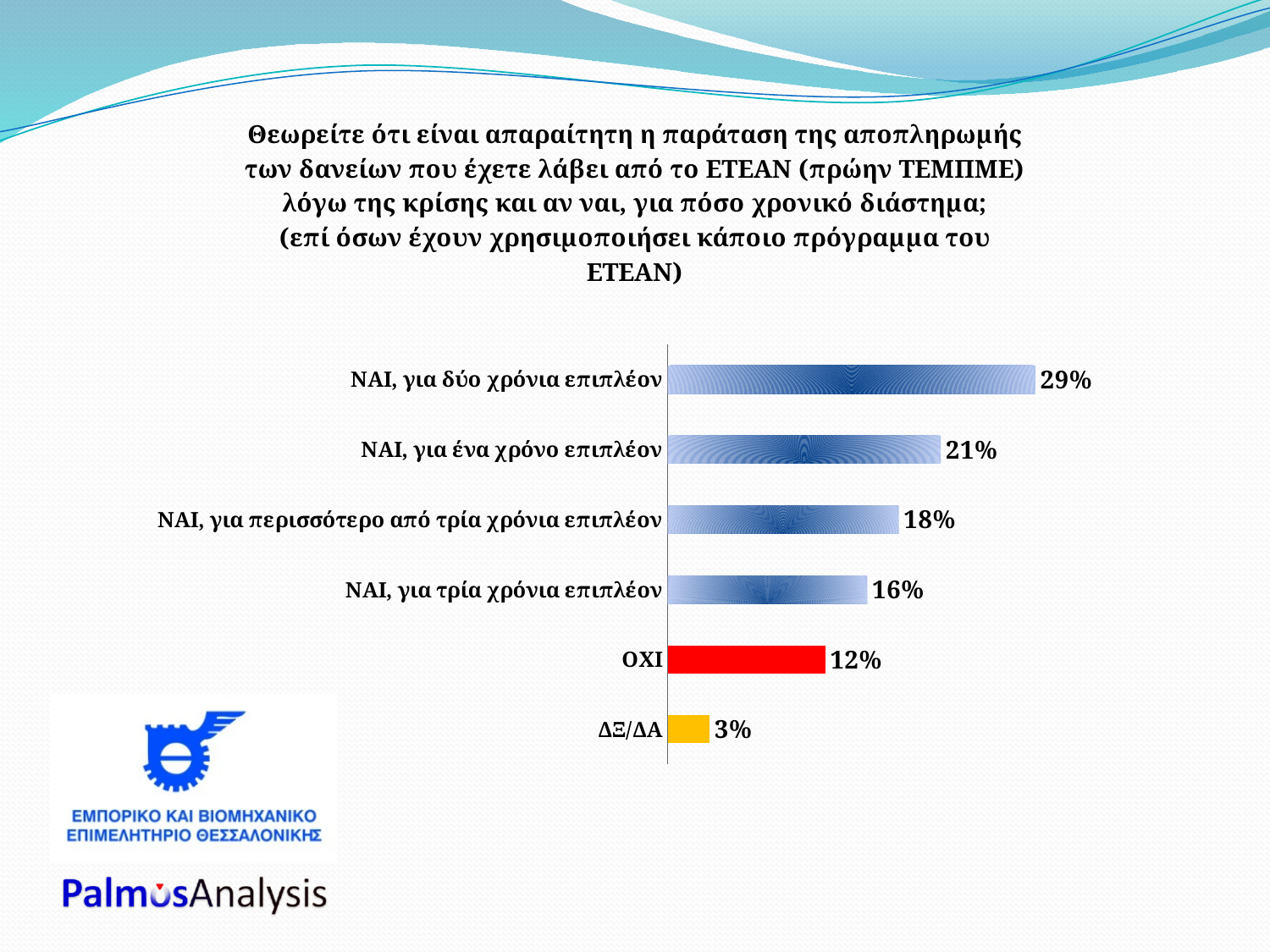
What is the difference between the values for "ΝΑΙ, για δύο χρόνια επιπλέον" and "ΝΑΙ, για ένα χρόνο επιπλέον"? 8% How many categories are shown in the chart? 6 What is the difference between the values for "ΟΧΙ" and "ΔΞ/ΔΑ"? 9% What is the value for "ΔΞ/ΔΑ"? 3% What is the value for "ΝΑΙ, για δύο χρόνια επιπλέον"? 29% What colour is the bar for "ΟΧΙ"? Red Which category has the highest value? ΝΑΙ, για δύο χρόνια επιπλέον What is the value for "ΝΑΙ, για τρία χρόνια επιπλέον"? 16% What kind of chart is shown on the slide? Bar chart Which category has the lowest value? ΔΞ/ΔΑ Which is larger: the value for "ΝΑΙ, για περισσότερο από τρία χρόνια επιπλέον" or the value for "ΝΑΙ, για τρία χρόνια επιπλέον"? ΝΑΙ, για περισσότερο από τρία χρόνια επιπλέον What is the value for "ΟΧΙ"? 12%